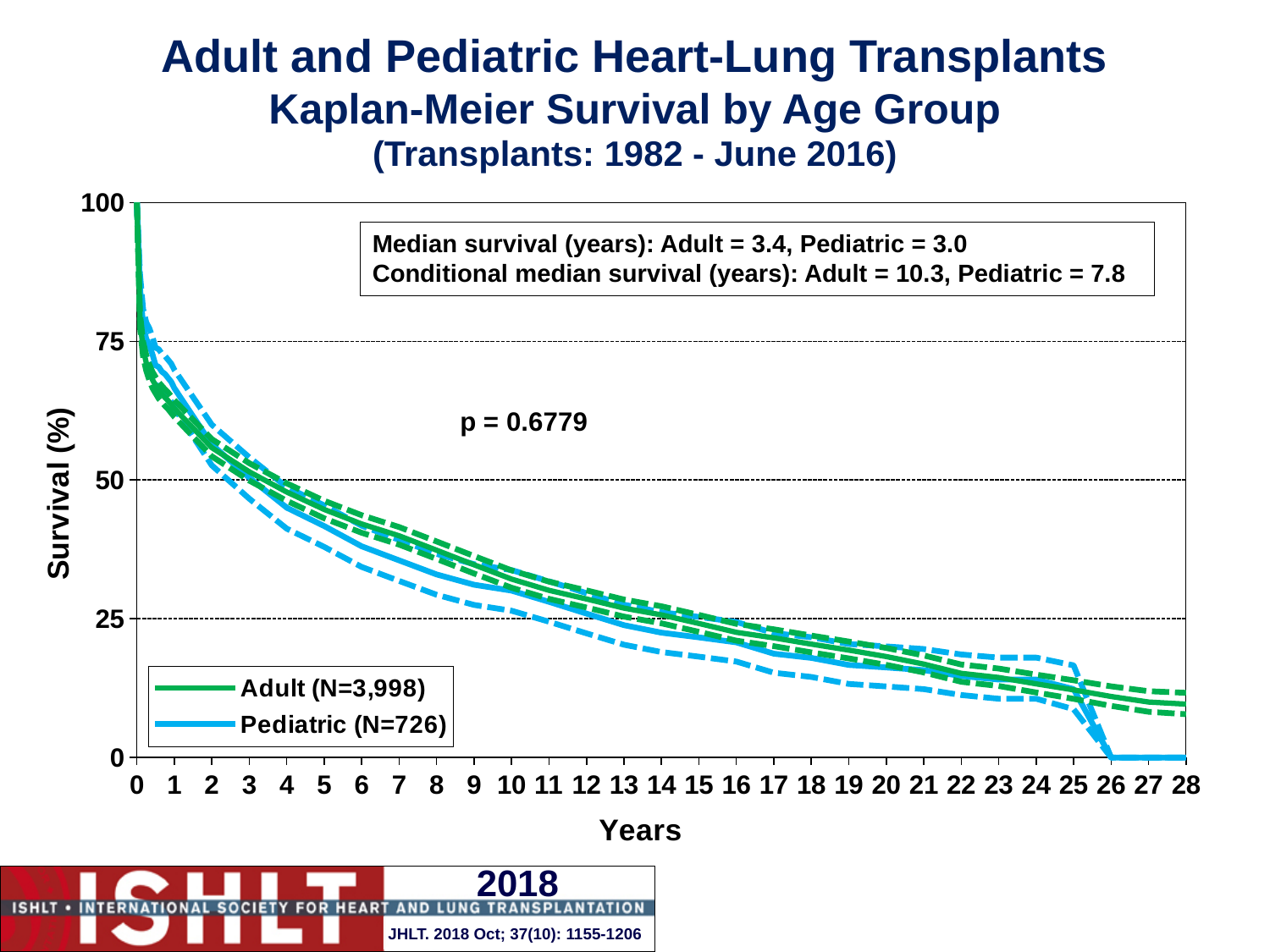
Is the Pediatric survival at 20 years greater or less than 25%? less What kind of chart is shown on the slide? line chart What is the median survival in years for the Pediatric group? 3.0 Is the Adult survival at 10 years greater or less than 25%? greater What is the conditional median survival in years for the Pediatric group? 7.8 What is the p-value shown on the chart? p = 0.6779 What is the difference in conditional median survival (years) between the Adult and Pediatric groups? 2.5 Which group has the higher conditional median survival, Adult or Pediatric? Adult What is the conditional median survival in years for the Adult group? 10.3 What is the median survival in years for the Adult group? 3.4 How many series does the legend list? 2 Do the survival curves rise or fall as years increase? fall